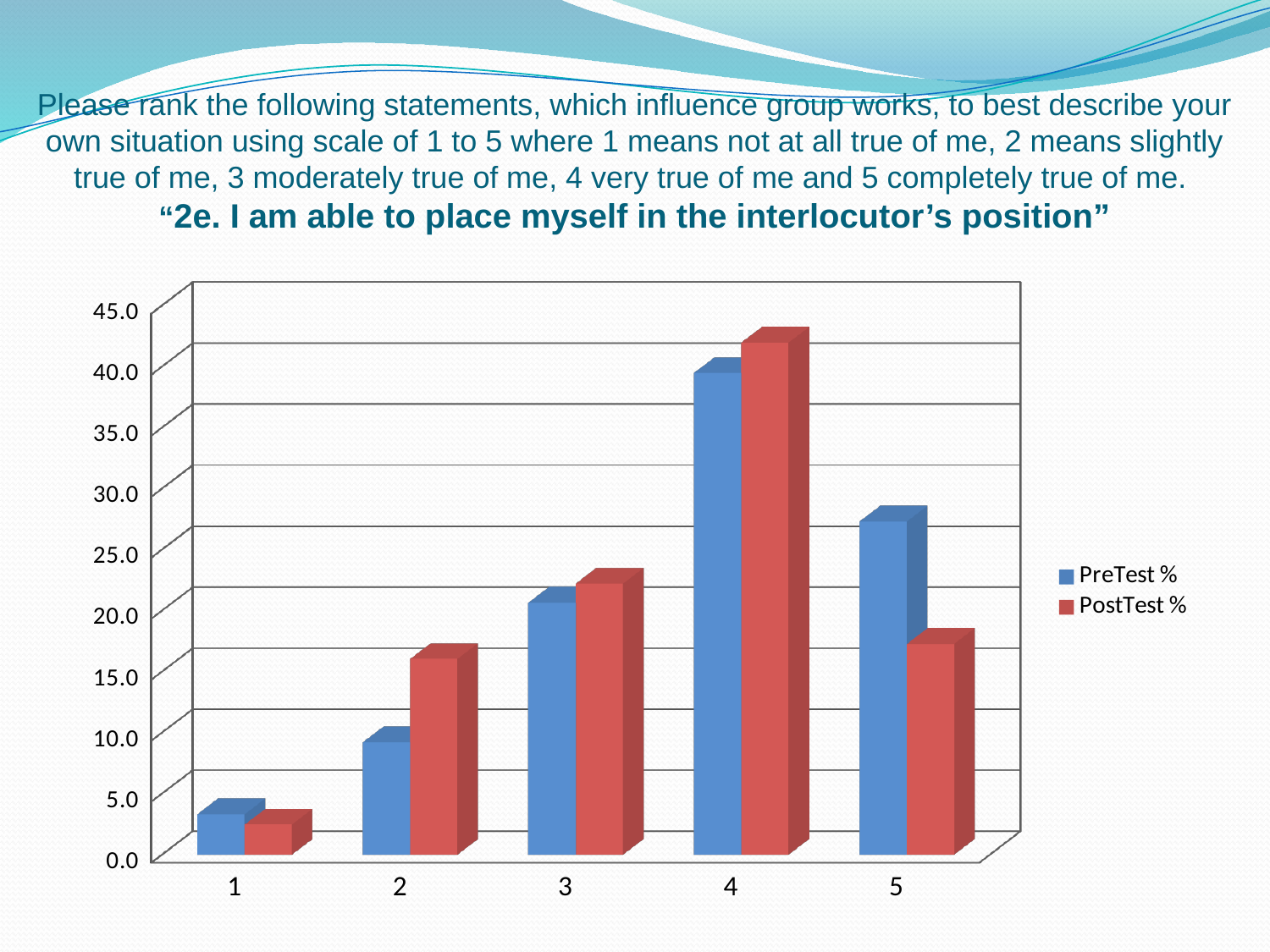
Is the PreTest % value for category 2 greater or less than 10.0? less Which category has the lowest PostTest % value? 1 Which category has the highest PostTest % value? 4 What kind of chart is shown on the slide? bar chart Is the PostTest % value for category 4 greater or less than 40.0? greater For category 5, which is larger, PreTest % or PostTest %? PreTest % How many series does the legend list? 2 Is the PostTest % value for category 5 greater or less than 20.0? less What are the two series names listed in the legend? PreTest % and PostTest % Which category has the highest PreTest % value? 4 For category 2, which is larger, PreTest % or PostTest %? PostTest % How many categories are shown on the x axis? 5